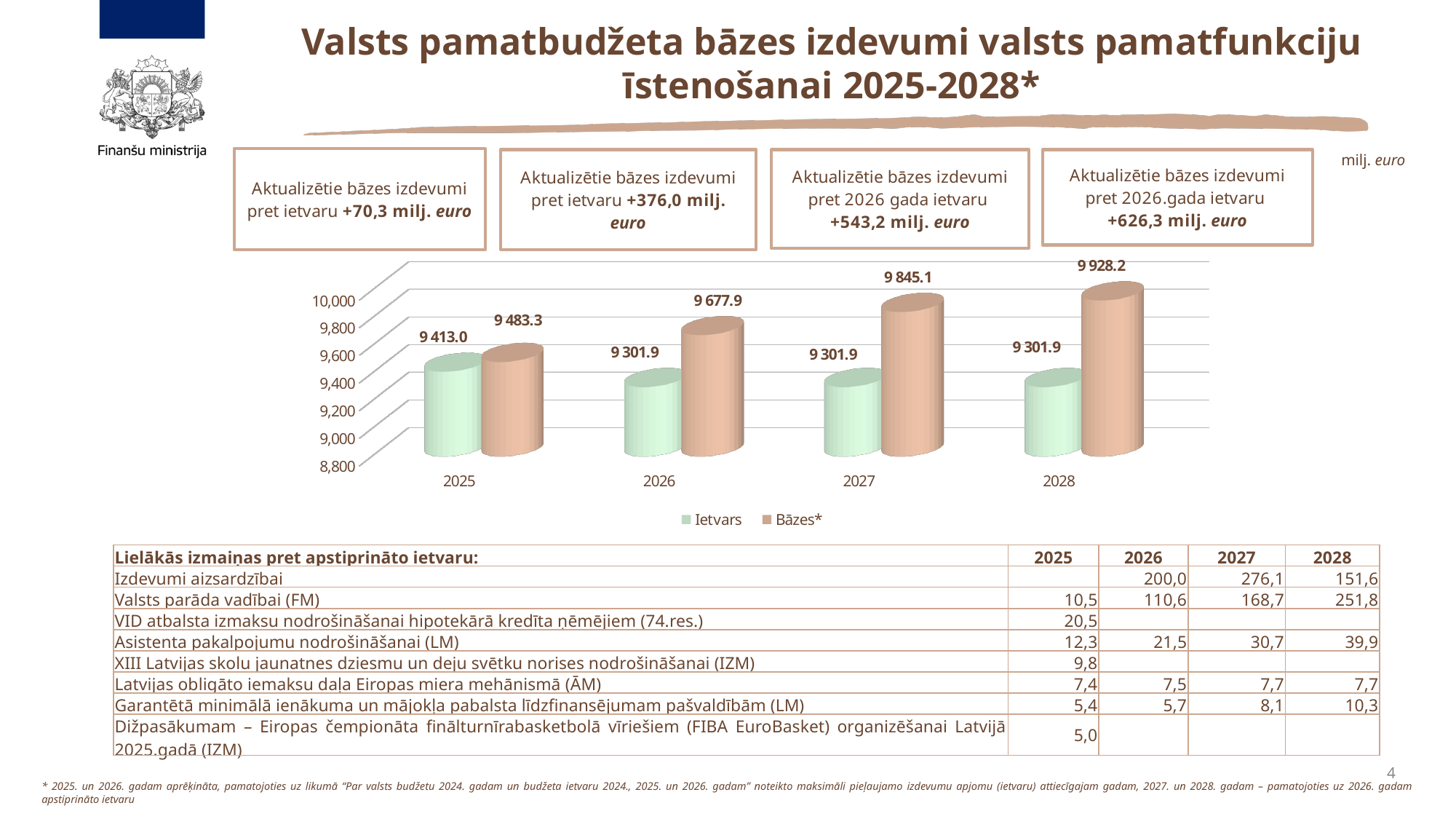
What is the Bāzes* value for 2027? 9 845.1 What is the difference between the Bāzes* and Ietvars values for 2028? 626.3 What is the difference between the Bāzes* values for 2027 and 2026? 167.2 What kind of chart is shown on the slide? Bar chart Which year has the highest Ietvars value? 2025 What is the Ietvars value for 2025? 9 413.0 What is the Bāzes* value for 2026? 9 677.9 Which is larger in 2025, the Ietvars value or the Bāzes* value? Bāzes* Do the Bāzes* values rise or fall from 2025 to 2028? Rise Which year has the highest Bāzes* value? 2028 How many years are shown on the x axis of the chart? 4 How many series does the chart legend list? 2